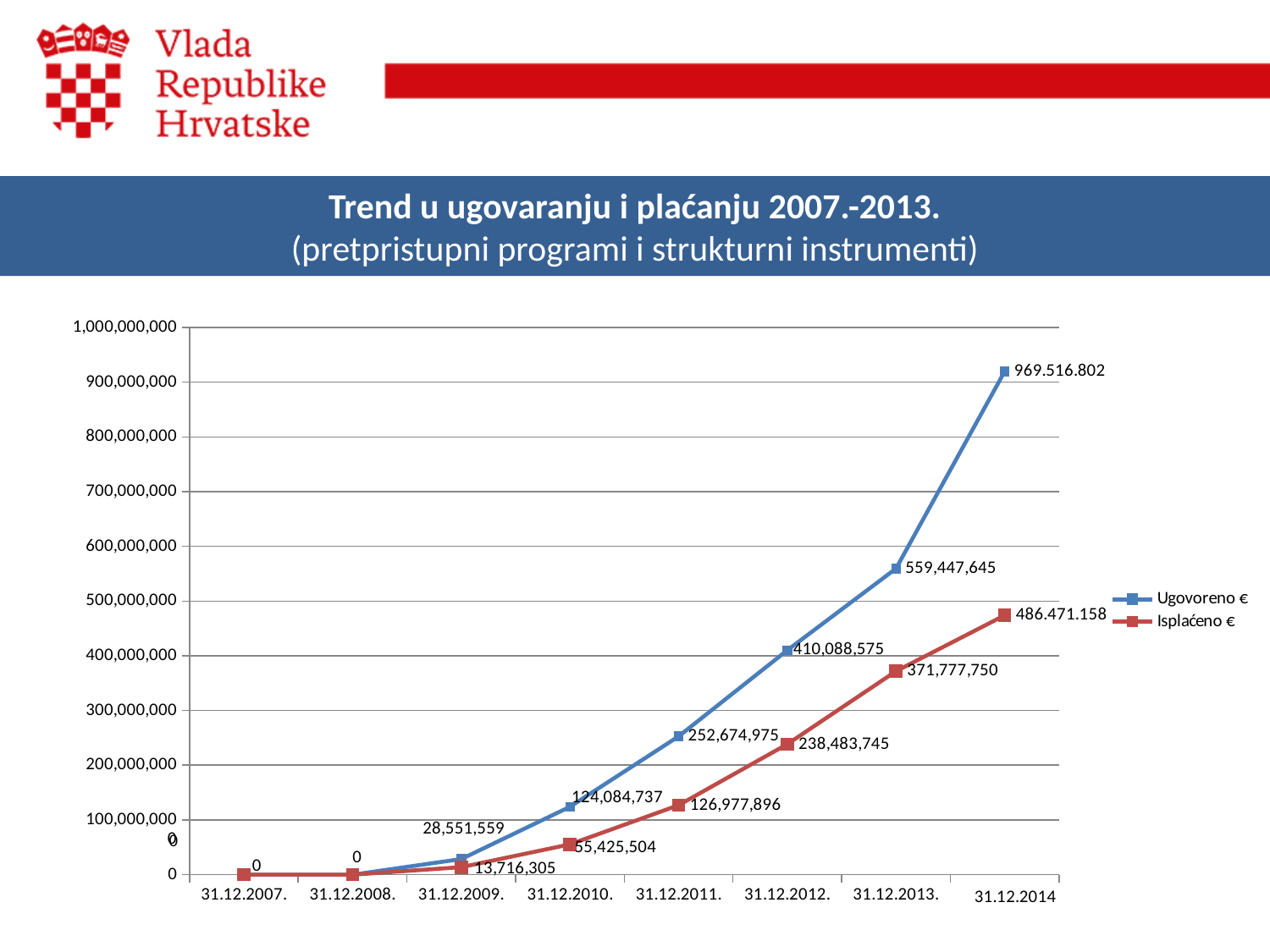
What is the value of Ugovoreno € at 31.12.2013.? 559,447,645 What kind of chart is shown on the slide? line chart What is the value of Ugovoreno € at 31.12.2010.? 124,084,737 What is the value of Isplaćeno € at 31.12.2012.? 238,483,745 How many dates are shown on the x axis? 8 At which date does Ugovoreno € reach its highest value? 31.12.2014 What is the difference between Ugovoreno € and Isplaćeno € at 31.12.2013.? 187,669,895 What is the value of Isplaćeno € at 31.12.2009.? 13,716,305 How many series does the legend list? 2 What is the difference between Ugovoreno € and Isplaćeno € at 31.12.2011.? 125,697,079 Is the value for Isplaćeno € at 31.12.2014 greater or less than 400,000,000? greater At 31.12.2012., which series has the larger value, Ugovoreno € or Isplaćeno €? Ugovoreno €